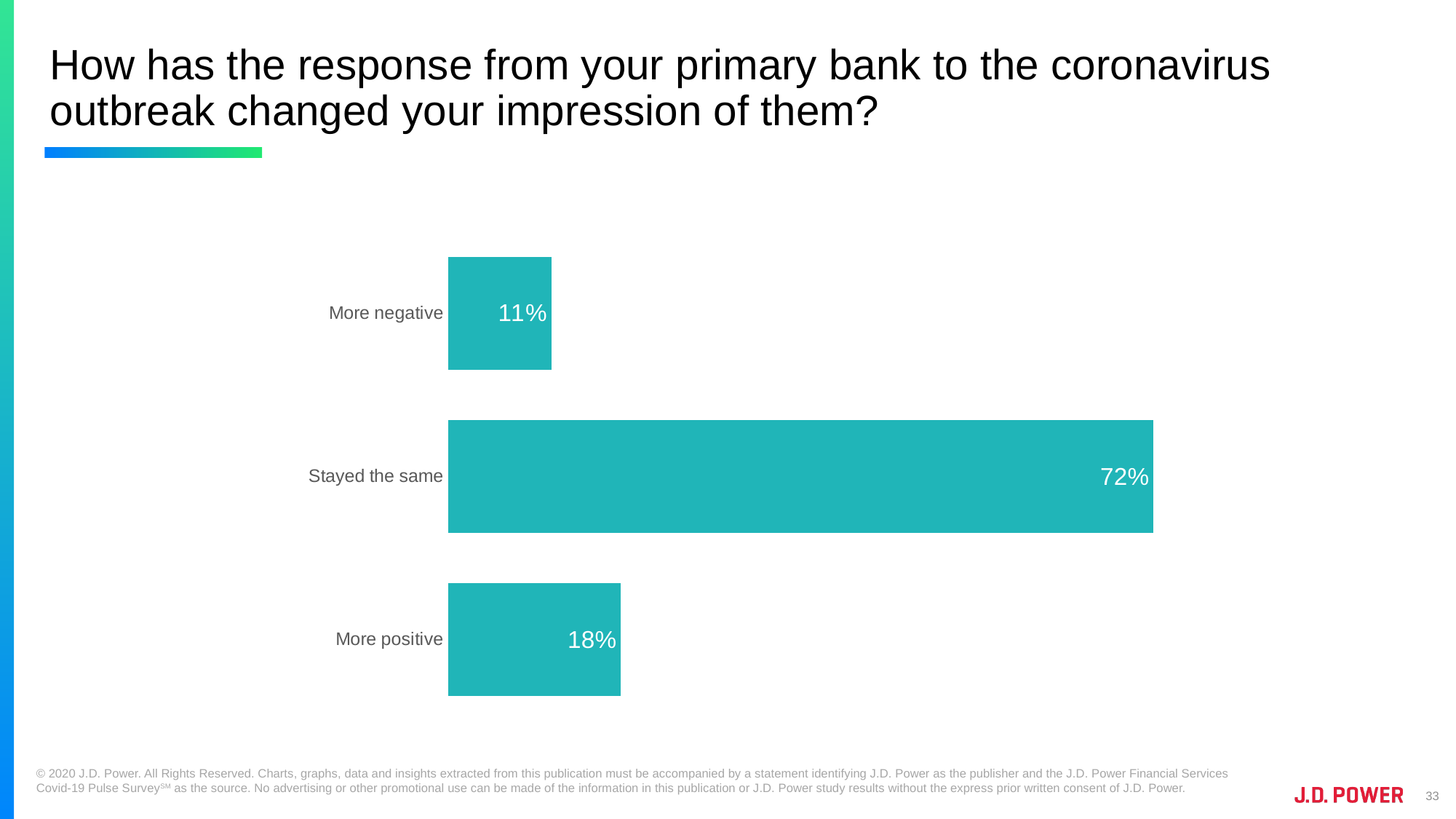
What percentage of respondents said their impression became more positive? 18% Which response category has the highest percentage? Stayed the same Which is larger, the percentage for 'More positive' or for 'More negative'? More positive What percentage of respondents said their impression stayed the same? 72% What is the total of the three percentages shown in the chart? 101% What is the difference in percentage points between 'More positive' and 'More negative'? 7 What colour are the bars in the chart? Teal What is the difference in percentage points between 'Stayed the same' and 'More positive'? 54 Which response category has the lowest percentage? More negative What percentage of respondents said their impression of their primary bank became more negative? 11% How many response categories are shown in the chart? 3 What type of chart is shown on the slide? Bar chart